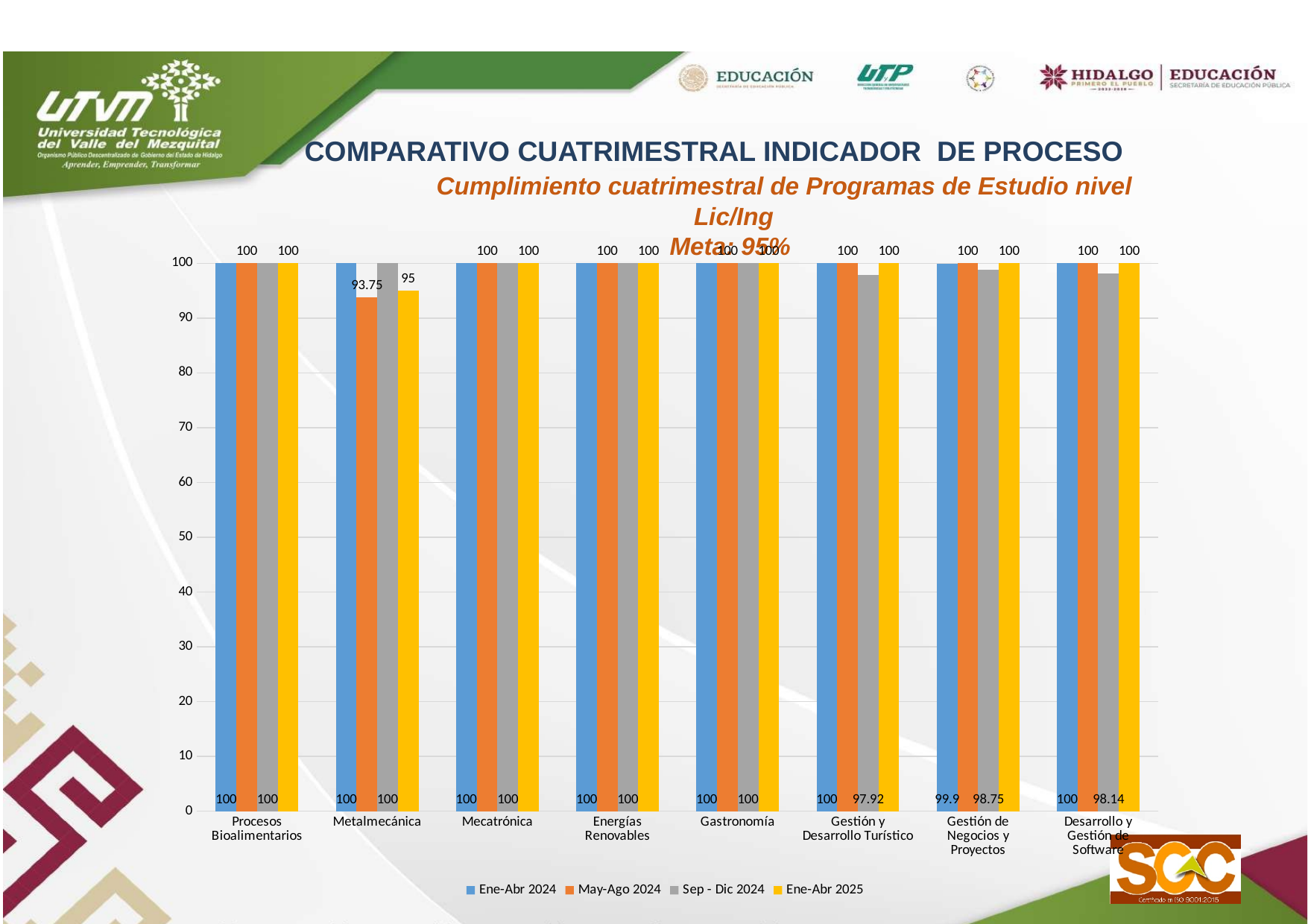
For Metalmecánica, what is the difference between the Ene-Abr 2025 value and the May-Ago 2024 value? 1.25 What is the Sep - Dic 2024 value for Gestión y Desarrollo Turístico? 97.92 What is the Sep - Dic 2024 value for Desarrollo y Gestión de Software? 98.14 Which category has the lowest May-Ago 2024 value? Metalmecánica How many categories (programs) are shown on the x axis? 8 What is the May-Ago 2024 value for Metalmecánica? 93.75 What is the Ene-Abr 2024 value for Gestión de Negocios y Proyectos? 99.9 For the Sep - Dic 2024 series, which is larger: Gestión de Negocios y Proyectos or Desarrollo y Gestión de Software? Gestión de Negocios y Proyectos What target (Meta) is stated in the chart title? 95% How many series does the legend list? 4 What kind of chart is shown on the slide? Bar chart What is the Ene-Abr 2025 value for Metalmecánica? 95